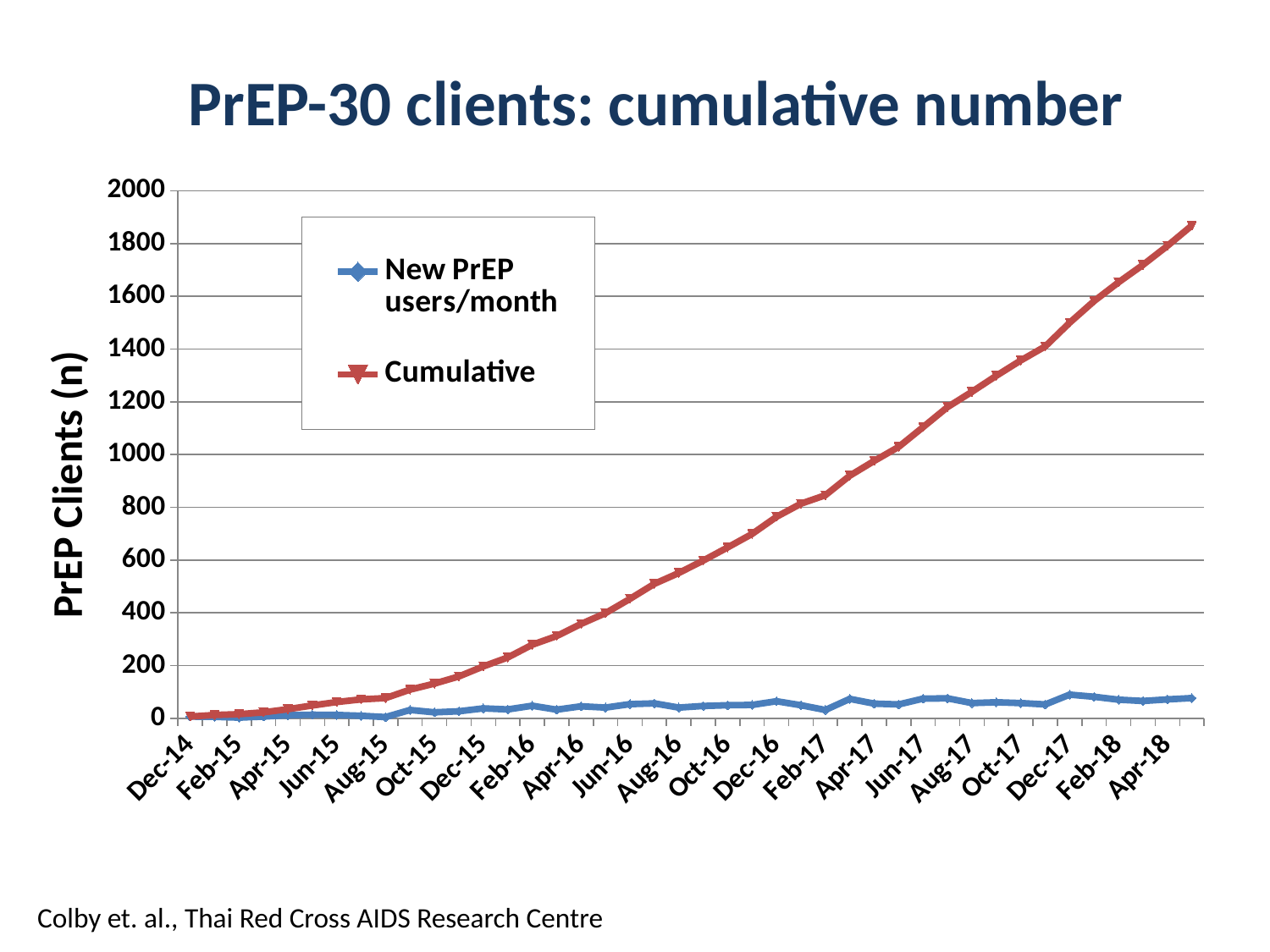
What is the label on the y axis? PrEP Clients (n) How many series does the legend list? 2 What kind of chart is shown on the slide? Line chart Which series reaches the highest value on the chart? Cumulative Which series is higher at Apr-18, New PrEP users/month or Cumulative? Cumulative Is the Cumulative value at Aug-17 greater or less than 1200? greater Does the Cumulative series rise or fall from Dec-14 to Apr-18? Rise Is the Cumulative value at Apr-16 greater or less than 400? less What is the title of the chart? PrEP-30 clients: cumulative number Is the New PrEP users/month value at Dec-17 greater or less than 200? less